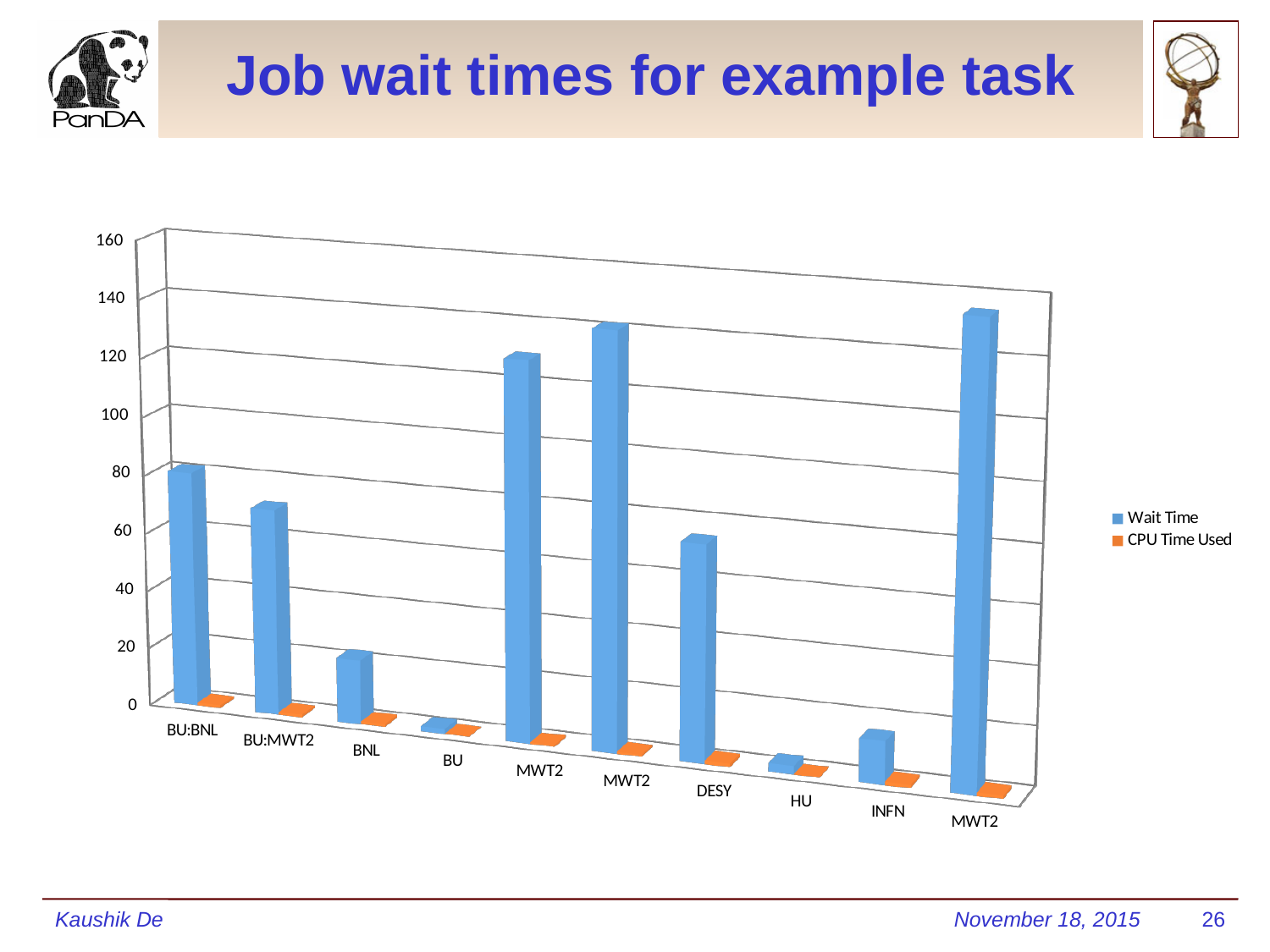
Is the Wait Time for INFN greater or less than 40? less Which has the larger Wait Time, BU:BNL or BU:MWT2? BU:BNL Is the Wait Time for HU greater or less than 20? less What are the two series named in the legend? Wait Time and CPU Time Used How many categories are shown along the x axis? 10 How many series does the legend list? 2 Is the Wait Time for BU:BNL greater or less than 60? greater Which category has the highest Wait Time? MWT2 Which has the larger Wait Time, DESY or BNL? DESY What kind of chart is shown on the slide? bar chart